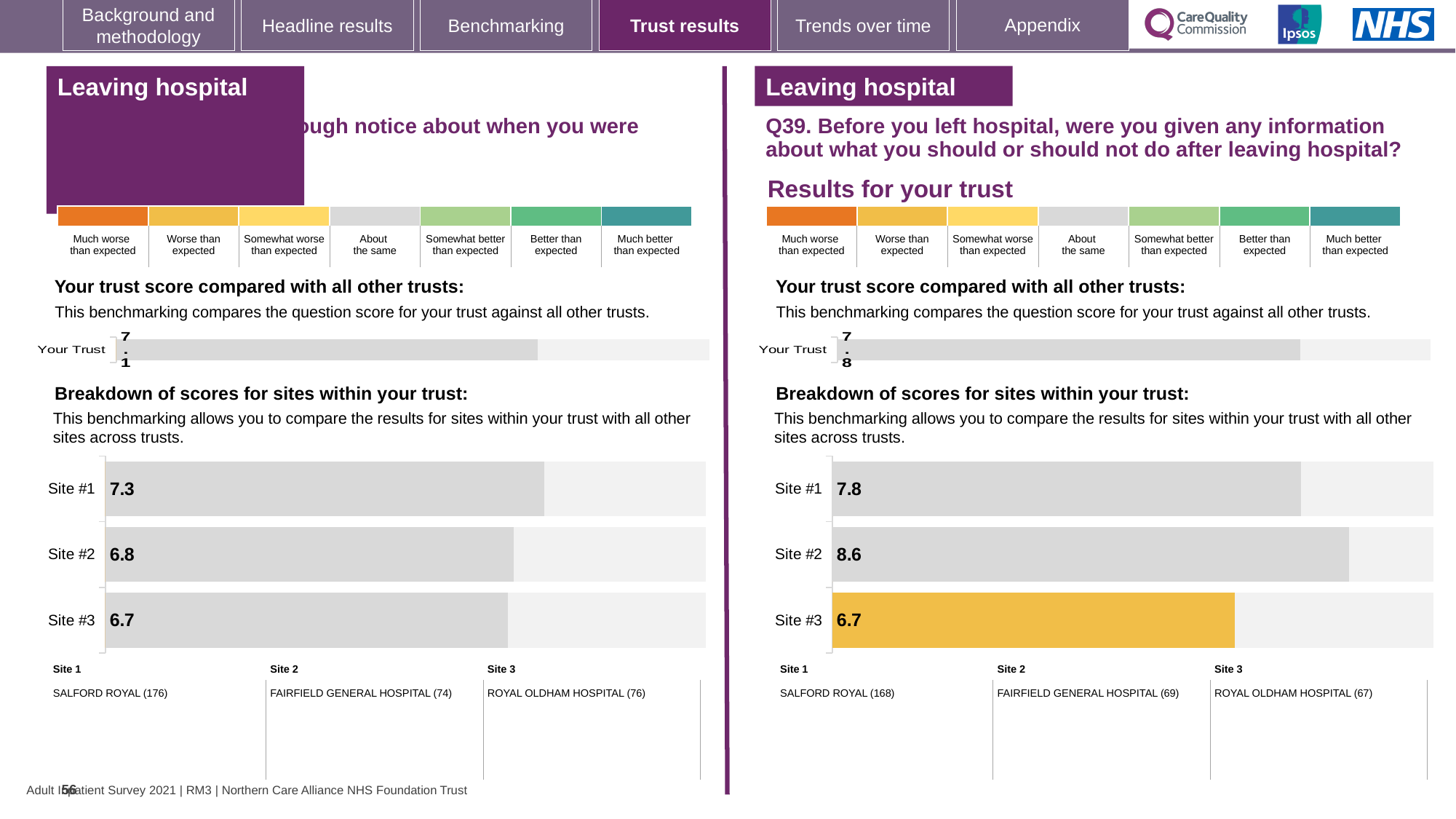
In the left-hand site breakdown chart, which site has the lowest score? Site #3 In the right-hand (Q39) site breakdown chart, which site's bar is coloured yellow rather than grey? Site #3 In the right-hand (Q39) 'Your trust score compared with all other trusts' chart, what is the score for Your Trust? 7.8 In the right-hand (Q39) site breakdown chart, which site has the highest score? Site #2 In the right-hand (Q39) site breakdown chart, what is the score for Site #2? 8.6 How many sites are shown in the left-hand site breakdown chart? 3 In the right-hand (Q39) site breakdown chart, which has the higher score, Site #1 or Site #3? Site #1 In the left-hand site breakdown chart, which has the higher score, Site #2 or Site #3? Site #2 In the left-hand site breakdown chart, what is the difference between the scores for Site #1 and Site #3? 0.6 What kind of chart is the right-hand (Q39) site breakdown chart? Bar chart In the left-hand site breakdown chart, what is the score for Site #1? 7.3 In the right-hand (Q39) site breakdown chart, what is the difference between the scores for Site #2 and Site #3? 1.9